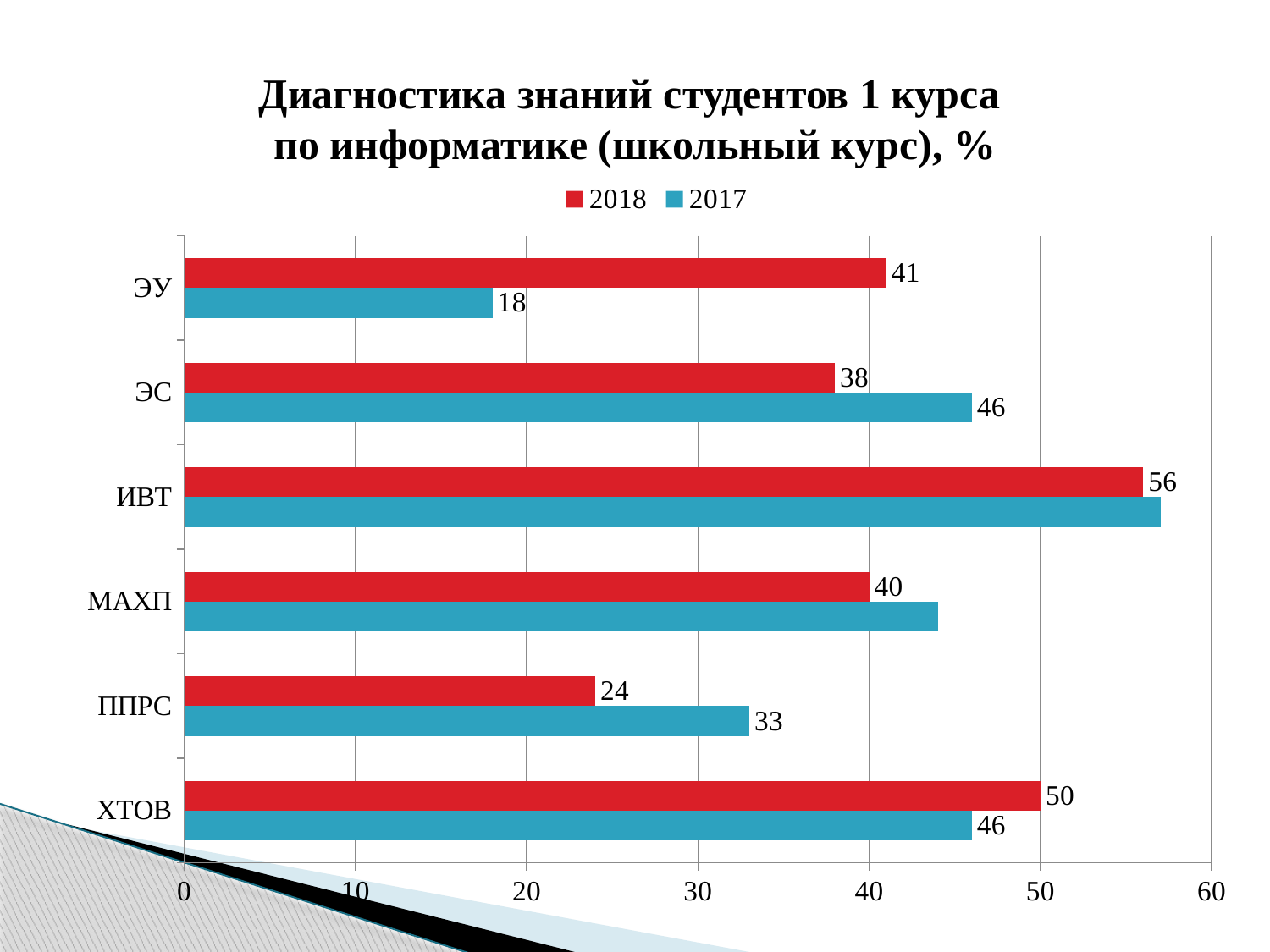
What is the 2017 value for ППРС? 33 Which category has the lowest 2017 value? ЭУ What is the 2018 value for ЭУ? 41 How many series does the legend list? 2 Is the 2017 value for ИВТ greater or less than 50? greater Which is larger for ЭС: the 2018 value or the 2017 value? 2017 What is the 2018 value for ХТОВ? 50 Which colour represents the 2017 series in the legend? blue Which category has the highest 2018 value? ИВТ What is the difference between the 2018 and 2017 values for ЭУ? 23 How many categories are shown on the chart? 6 What type of chart is shown on the slide? bar chart